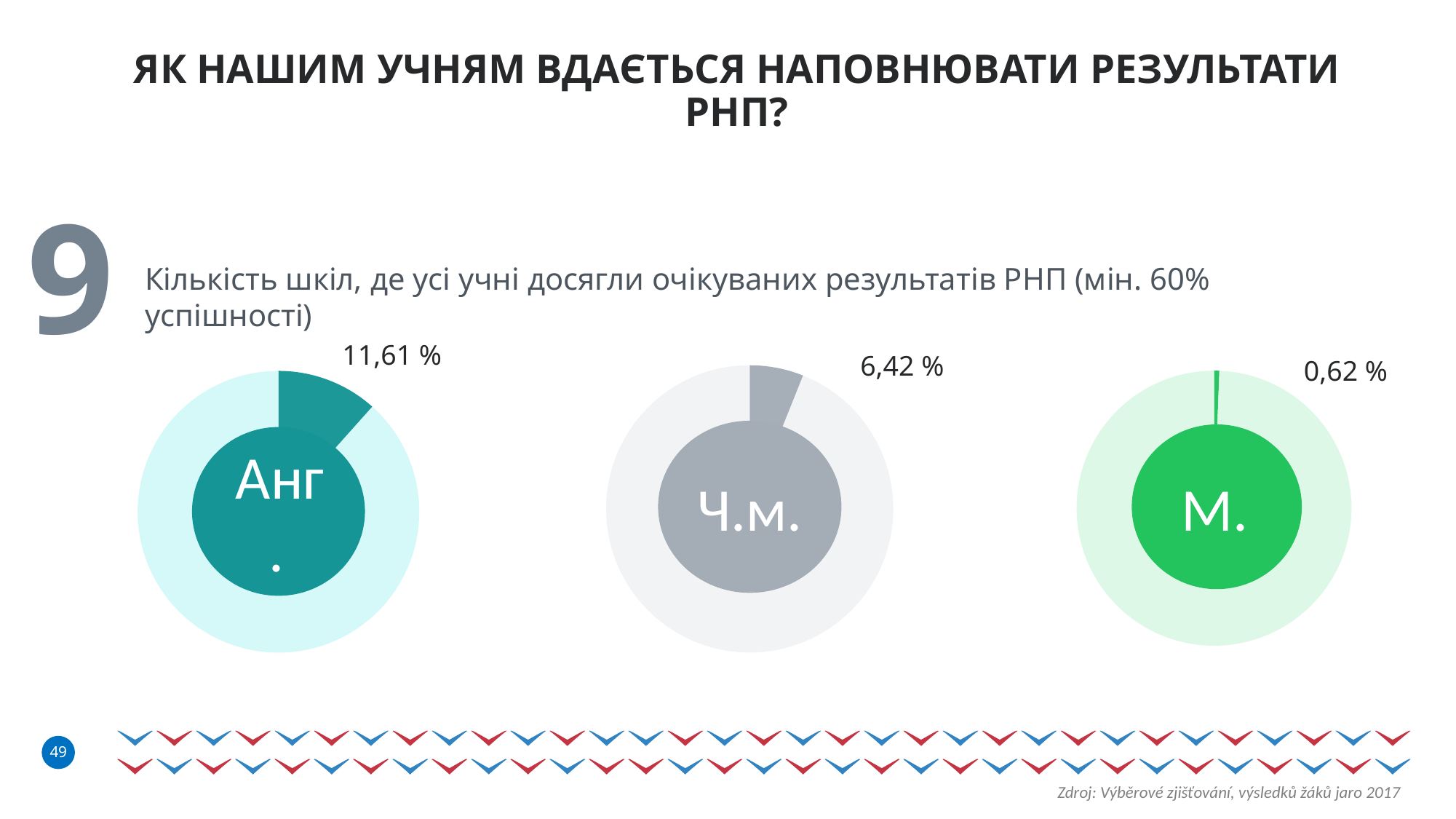
What value is shown on the right chart labelled М.? 0,62 % What is the difference between the value on the Анг. chart and the value on the Ч.м. chart? 5,19 % Which of the three charts (Анг., Ч.м., М.) shows the lowest value? М. What colour is the filled segment of the right chart labelled М.? Green What is the difference between the value on the Анг. chart and the value on the М. chart? 10,99 % What is the difference between the value on the Ч.м. chart and the value on the М. chart? 5,80 % Which of the three charts (Анг., Ч.м., М.) shows the highest value? Анг. How many charts are shown on the slide? 3 Which is larger: the value on the Ч.м. chart or the value on the М. chart? Ч.м. What value is shown on the left chart labelled Анг.? 11,61 % What value is shown on the middle chart labelled Ч.м.? 6,42 % What kind of chart is used for Анг., Ч.м. and М.? Doughnut (pie) chart